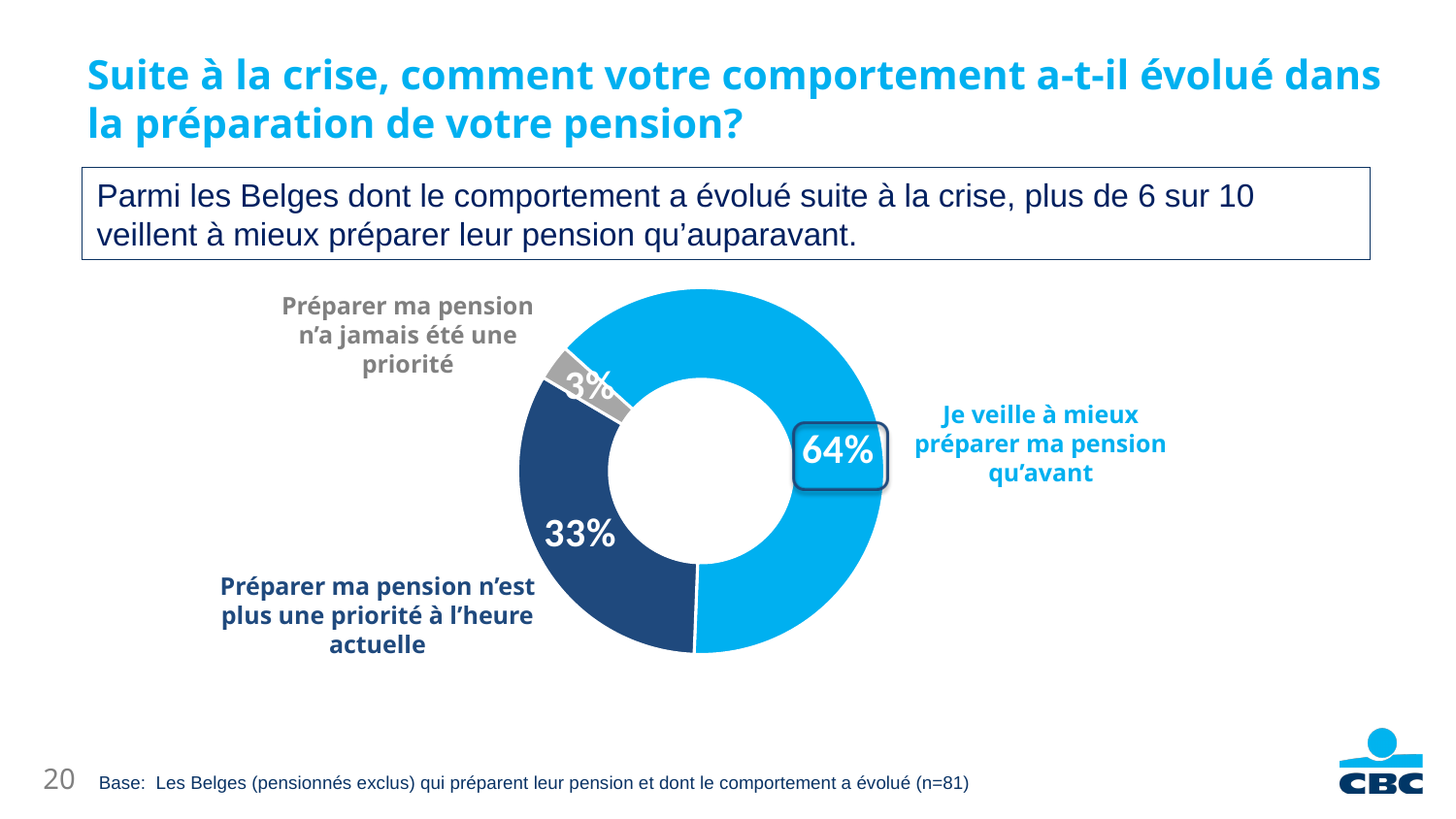
Which category has the largest share of the pie? Je veille à mieux préparer ma pension qu'avant What kind of chart is shown on the slide? Pie chart (doughnut) What share of respondents say "Préparer ma pension n'est plus une priorité à l'heure actuelle"? 33% Which category has the smallest share of the pie? Préparer ma pension n'a jamais été une priorité What is the sample size (n) given in the base note at the bottom of the slide? n=81 How many categories does the pie chart show? 3 What share of respondents say "Je veille à mieux préparer ma pension qu'avant"? 64% What colour is the slice for "Je veille à mieux préparer ma pension qu'avant"? Light blue What share of respondents say "Préparer ma pension n'a jamais été une priorité"? 3% What is the combined share of the two categories that say preparing their pension is not or never was a priority? 36% What is the difference in percentage points between "Je veille à mieux préparer ma pension qu'avant" and "Préparer ma pension n'est plus une priorité à l'heure actuelle"? 31 percentage points Which is larger: the share for "Préparer ma pension n'est plus une priorité à l'heure actuelle" or for "Préparer ma pension n'a jamais été une priorité"? Préparer ma pension n'est plus une priorité à l'heure actuelle